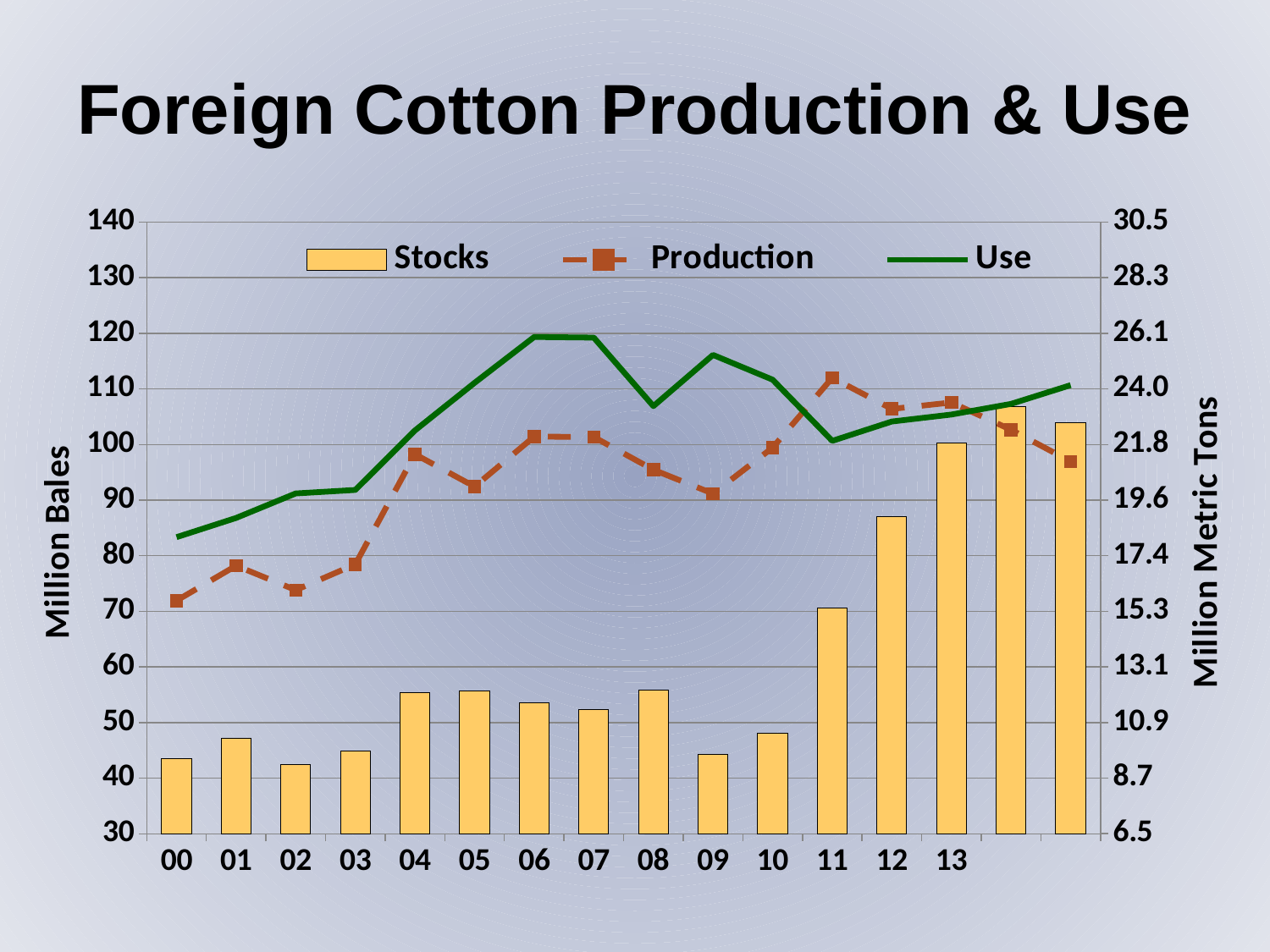
In which year is Use lowest? 00 What kind of chart is shown on the slide? A combination bar and line chart Is the Stocks value for 12 greater or less than 80? greater What is the title of the left vertical axis? Million Bales In which year is Production highest? 11 Which series is drawn as bars? Stocks Is the Use value for 06 greater or less than 110 on the left axis? greater In 11, which is larger, Production or Use? Production Do Stocks rise or fall from 10 to 13? Rise How many year labels are shown on the x axis? 14 Is the Stocks value for 00 greater or less than 50? less How many series does the legend list? 3